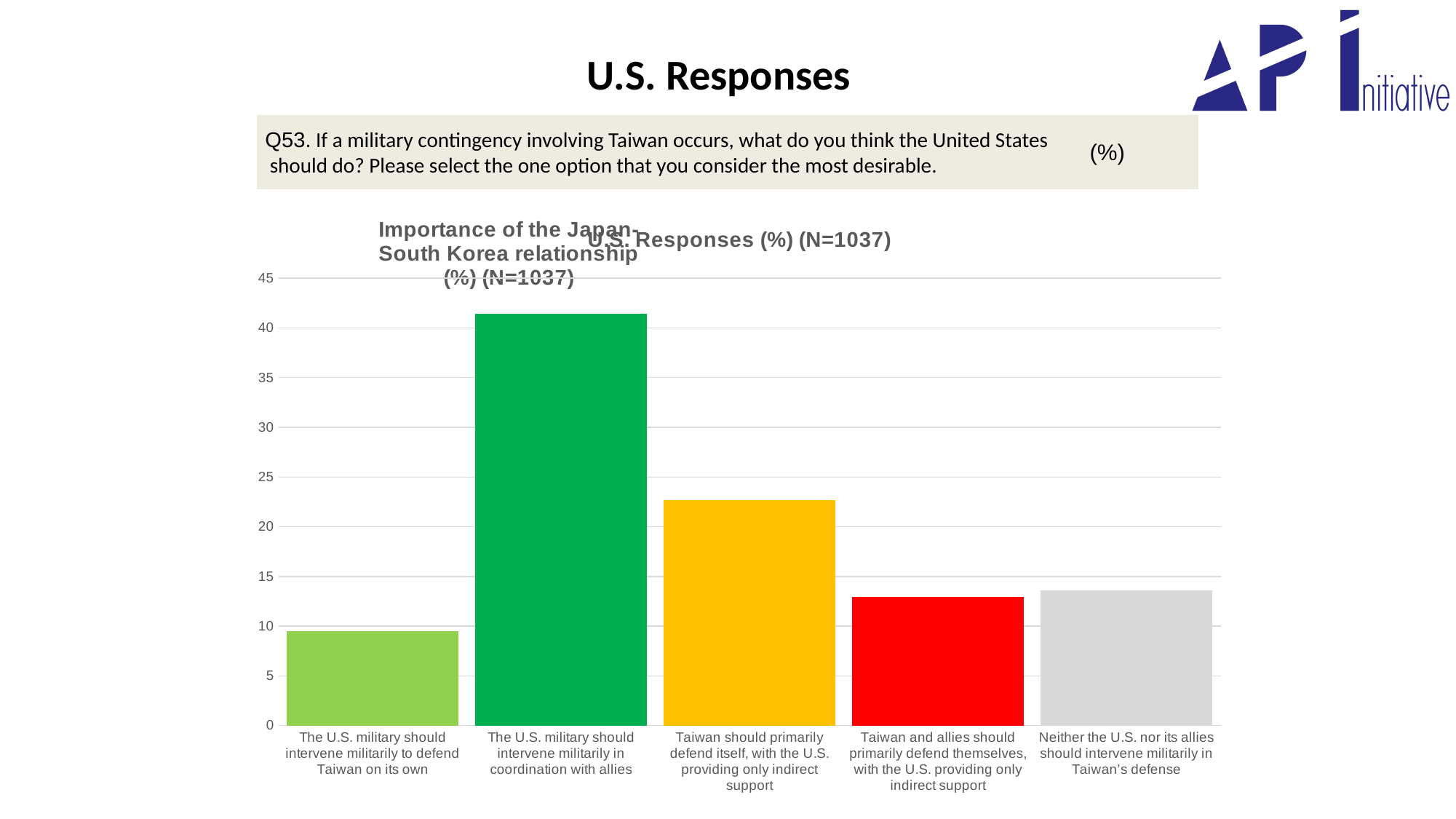
Is the value for 'Taiwan should primarily defend itself, with the U.S. providing only indirect support' greater or less than 25? less What kind of chart is shown on the slide? bar chart Is the value for 'The U.S. military should intervene militarily in coordination with allies' greater or less than 40? greater Which is larger: the value for 'The U.S. military should intervene militarily to defend Taiwan on its own' or the value for 'Taiwan and allies should primarily defend themselves, with the U.S. providing only indirect support'? Taiwan and allies should primarily defend themselves, with the U.S. providing only indirect support How many response categories are plotted on the chart? 5 Is the value for 'Taiwan should primarily defend itself, with the U.S. providing only indirect support' greater or less than 20? greater Which response option has the lowest value? The U.S. military should intervene militarily to defend Taiwan on its own Which response option has the highest value? The U.S. military should intervene militarily in coordination with allies What colour is the tallest bar on the chart? green